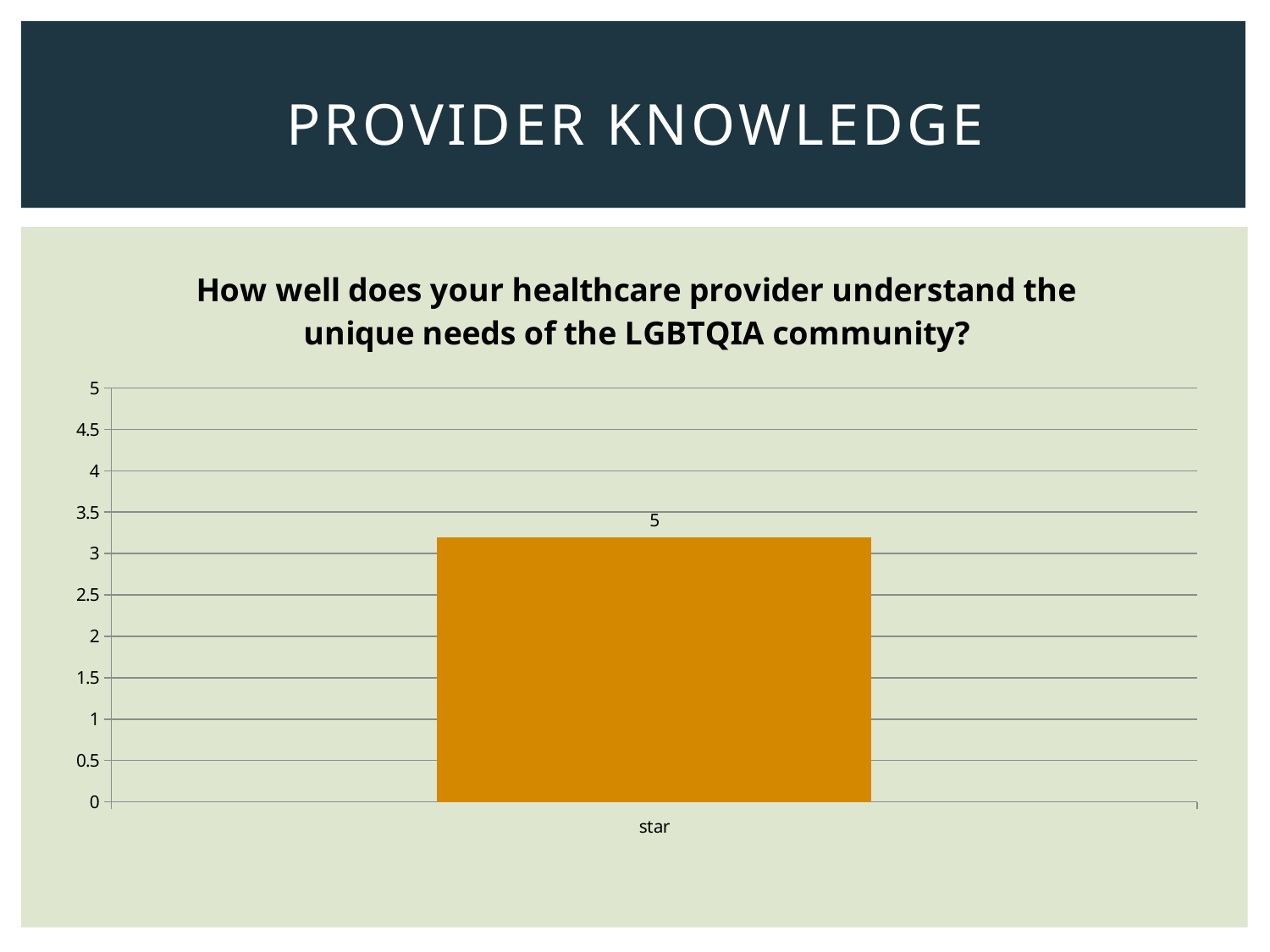
What is the category label shown on the x axis of the chart? star Is the value for star greater or less than 3? greater Is the value for star greater or less than 4? less Is the value for star greater or less than 2? greater What kind of chart is shown on the slide? bar chart What is the title of the chart? How well does your healthcare provider understand the unique needs of the LGBTQIA community? How many bars are plotted in the chart? 1 What is the highest value shown on the y axis of the chart? 5